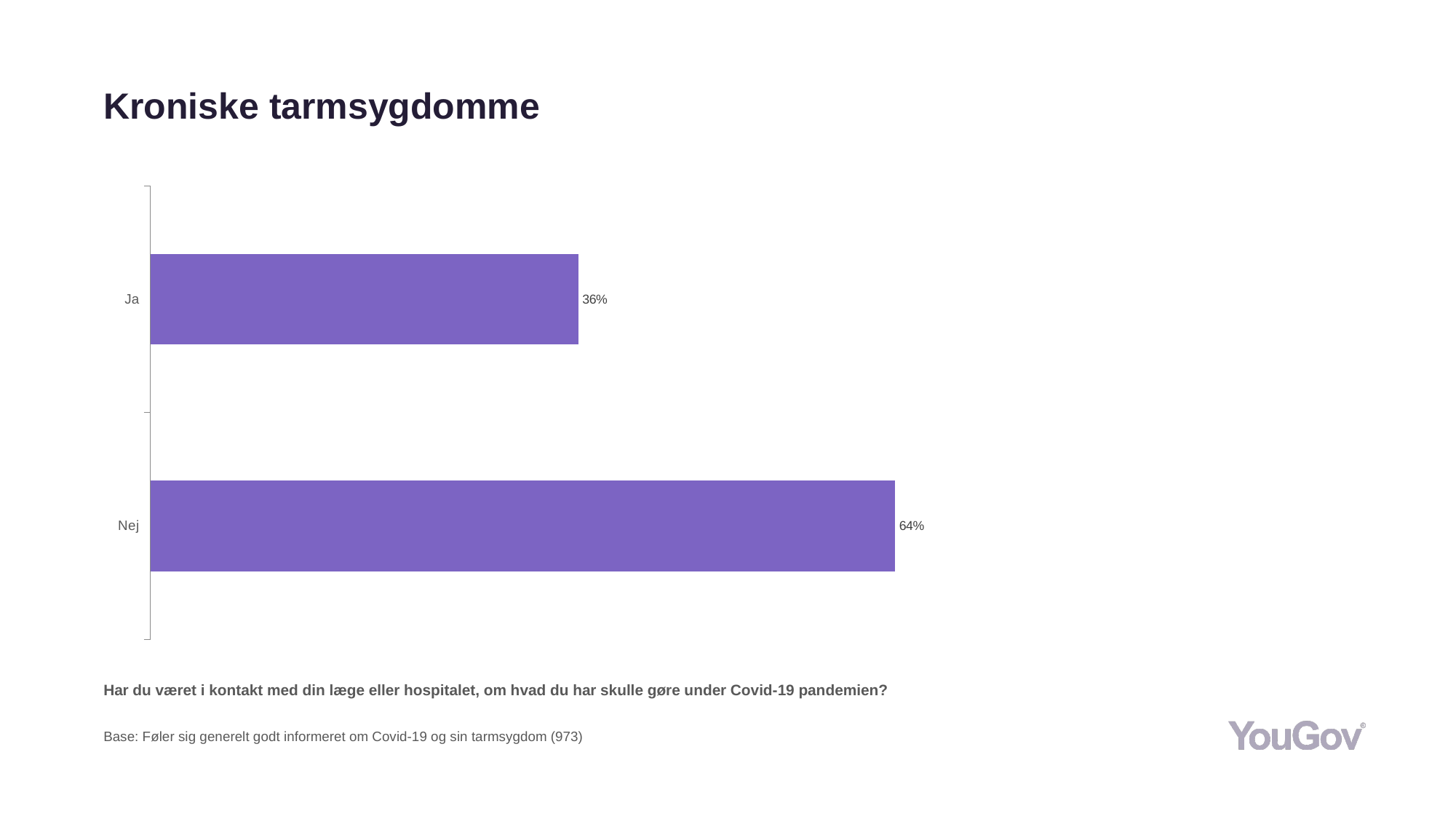
Which is larger, the value for Ja or the value for Nej? Nej What is the difference between the values for Nej and Ja? 28% How many categories are shown in the chart? 2 Which category has the lowest value? Ja What is the value for Nej? 64% What is the base size stated below the chart? 973 Which category has the highest value? Nej What is the value for Ja? 36% What is the total of the values for Ja and Nej? 100% What is the title of the slide? Kroniske tarmsygdomme What kind of chart is shown on the slide? Bar chart